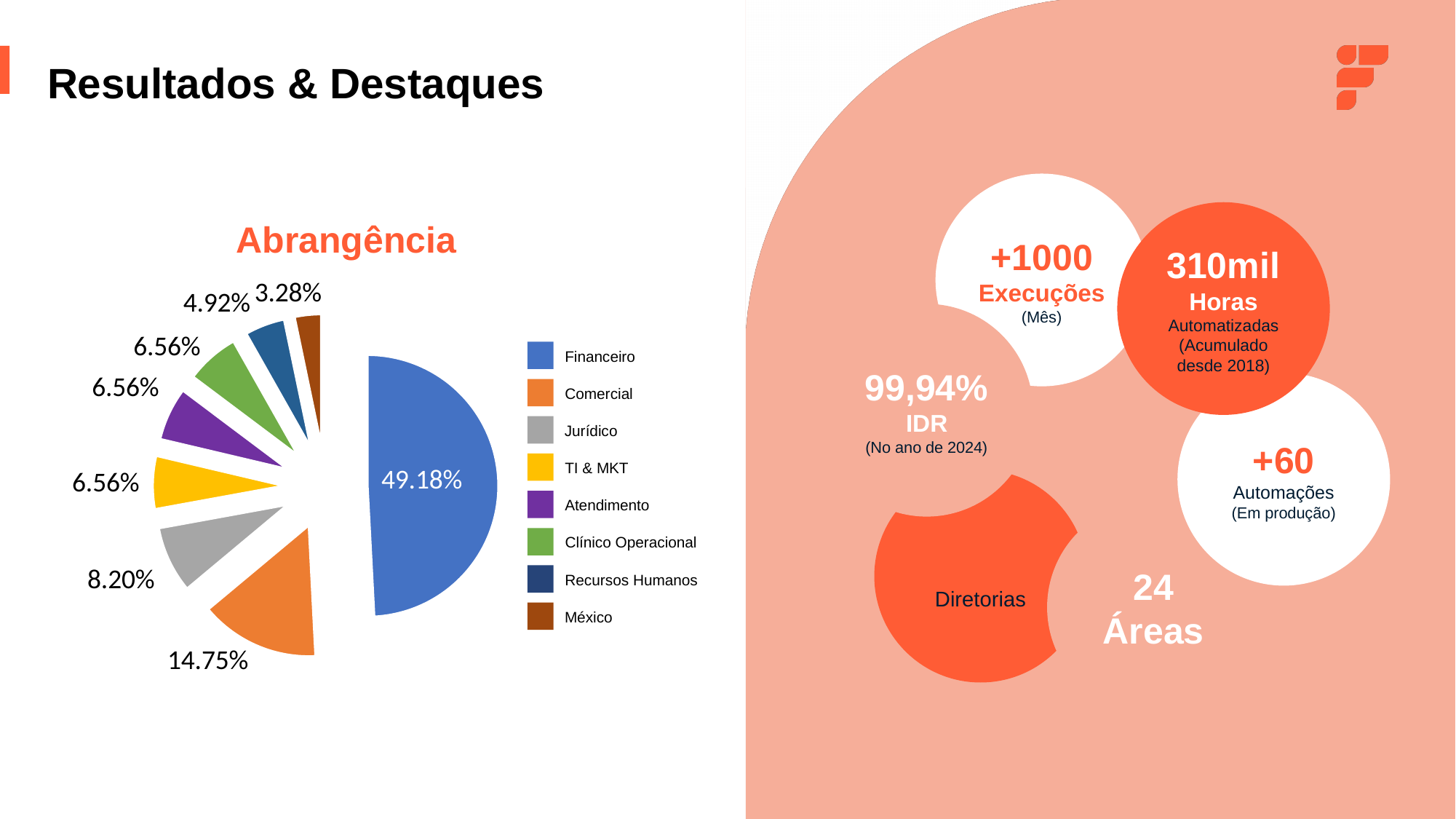
In the Abrangência pie chart, which is larger: Jurídico or Recursos Humanos? Jurídico In the Abrangência pie chart, what share does Comercial have? 14.75% In the Abrangência pie chart, what share does Jurídico have? 8.20% Which category has the smallest slice in the Abrangência pie chart? México In the Abrangência pie chart, what is the difference in percentage points between Financeiro and Comercial? 34.43 What type of chart is shown under the title "Abrangência"? pie chart In the Abrangência pie chart, what share does Financeiro have? 49.18% Which category has the largest slice in the Abrangência pie chart? Financeiro In the Abrangência pie chart, what share does Recursos Humanos have? 4.92% What colour is the Comercial slice in the Abrangência pie chart? orange In the Abrangência pie chart, what share does México have? 3.28% How many categories does the legend of the Abrangência pie chart list? 8